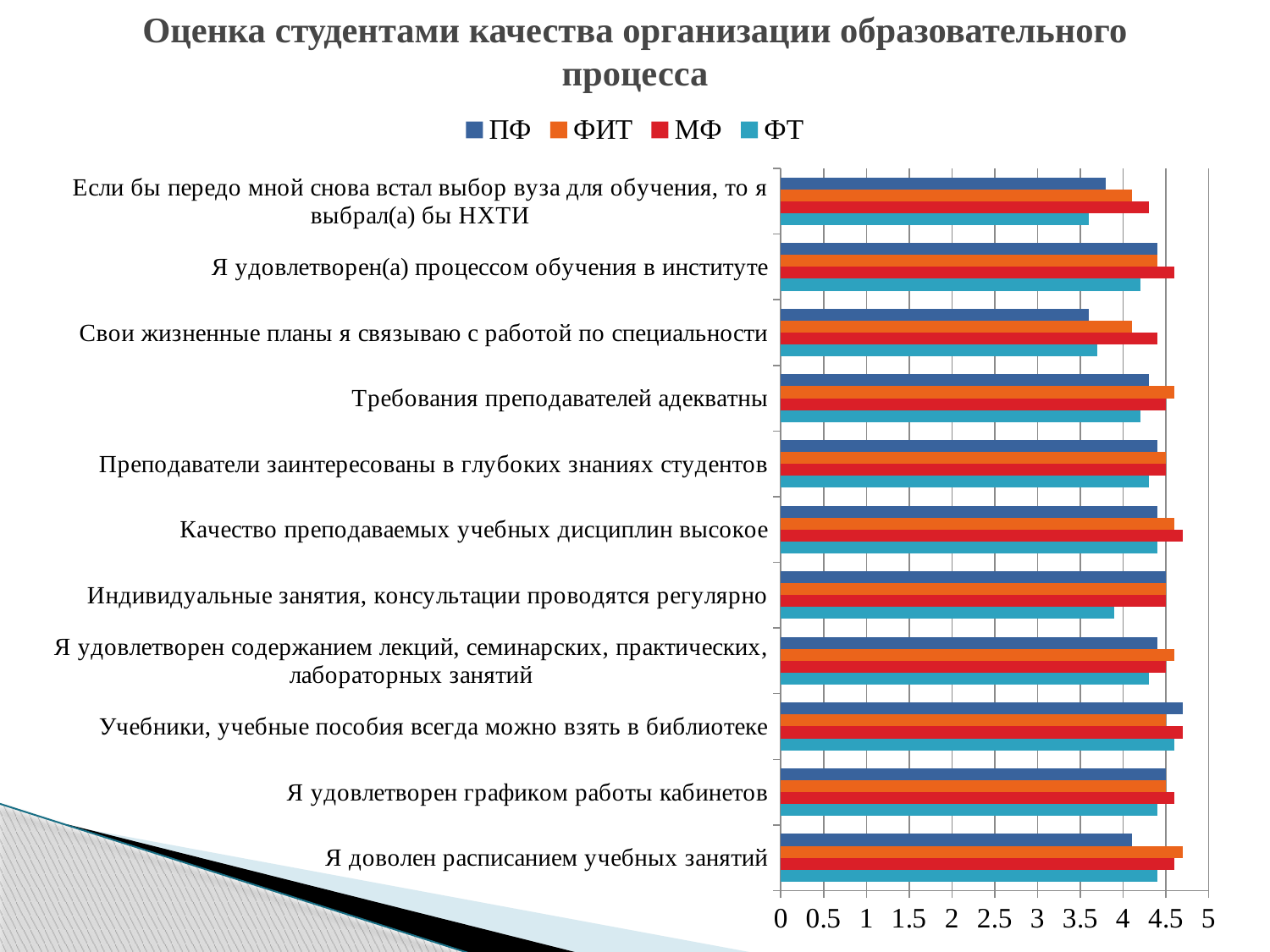
Is the value for ФТ on "Если бы передо мной снова встал выбор вуза для обучения, то я выбрал(а) бы НХТИ" greater or less than 4? less What kind of chart is shown on the slide? bar chart Is the value for ПФ on "Свои жизненные планы я связываю с работой по специальности" greater or less than 4? less For "Если бы передо мной снова встал выбор вуза для обучения, то я выбрал(а) бы НХТИ", which is larger: МФ or ФТ? МФ For "Свои жизненные планы я связываю с работой по специальности", which is larger: ПФ or МФ? МФ Is the value for ПФ on "Учебники, учебные пособия всегда можно взять в библиотеке" greater or less than 4.5? greater What is the title of the chart? Оценка студентами качества организации образовательного процесса Which series are listed in the legend? ПФ, ФИТ, МФ, ФТ For "Индивидуальные занятия, консультации проводятся регулярно", which series has the lowest value? ФТ How many categories (statements) are plotted on the chart? 11 How many series does the legend list? 4